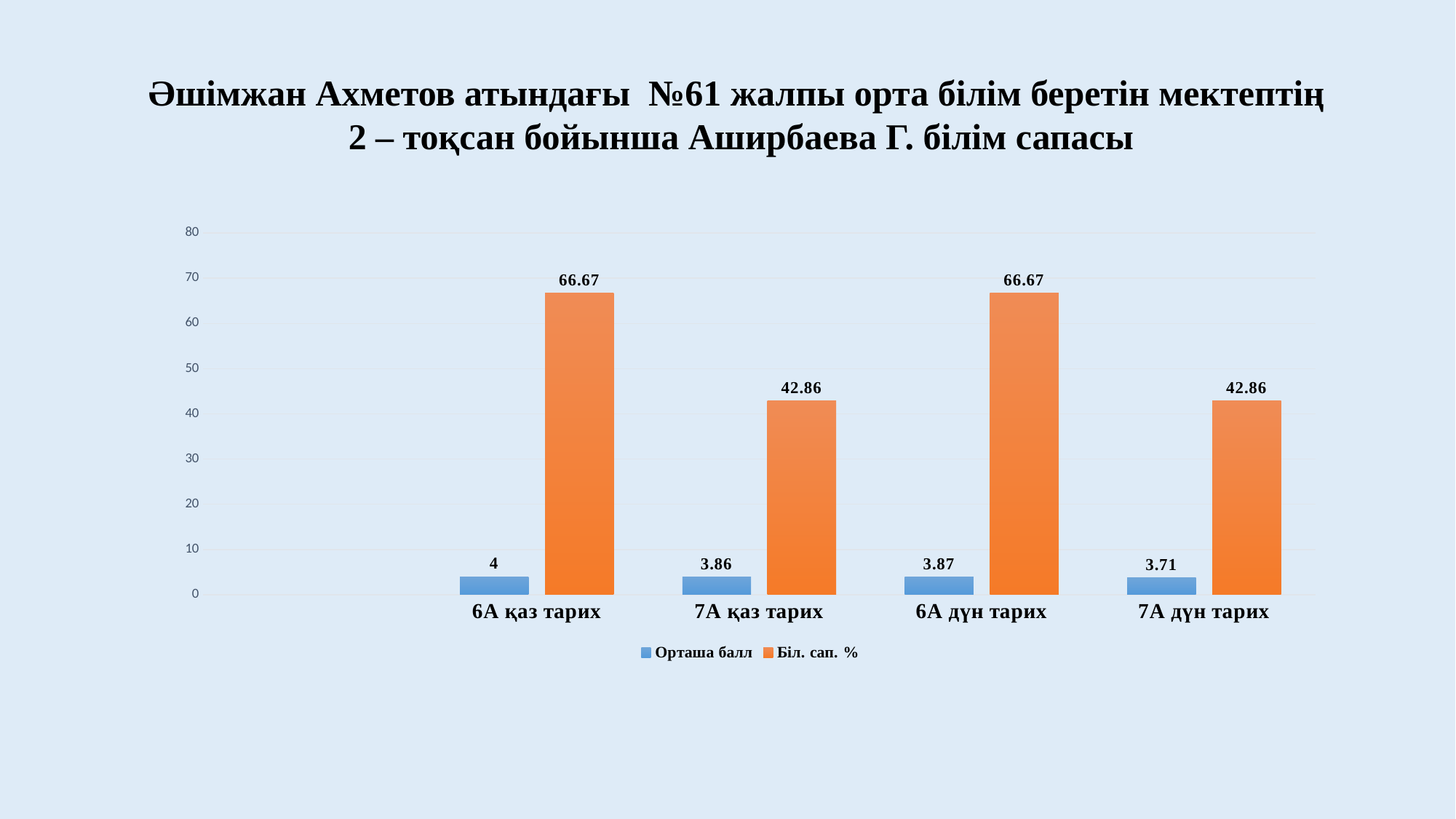
Which is larger, the Орташа балл for 7А қаз тарих or for 6А дүн тарих? 6А дүн тарих What kind of chart is shown on the slide? Bar chart What is the value of Біл. сап. % for 6А дүн тарих? 66.67 Which category has the lowest Орташа балл? 7А дүн тарих How many categories are shown on the x axis? 4 How many series does the legend list? 2 What is the value of Орташа балл for 6А қаз тарих? 4 Which colour represents the Біл. сап. % series? Orange Which category has the highest Орташа балл? 6А қаз тарих What is the value of Орташа балл for 7А дүн тарих? 3.71 What is the difference between the Біл. сап. % values for 6А қаз тарих and 7А қаз тарих? 23.81 What is the value of Біл. сап. % for 7А қаз тарих? 42.86